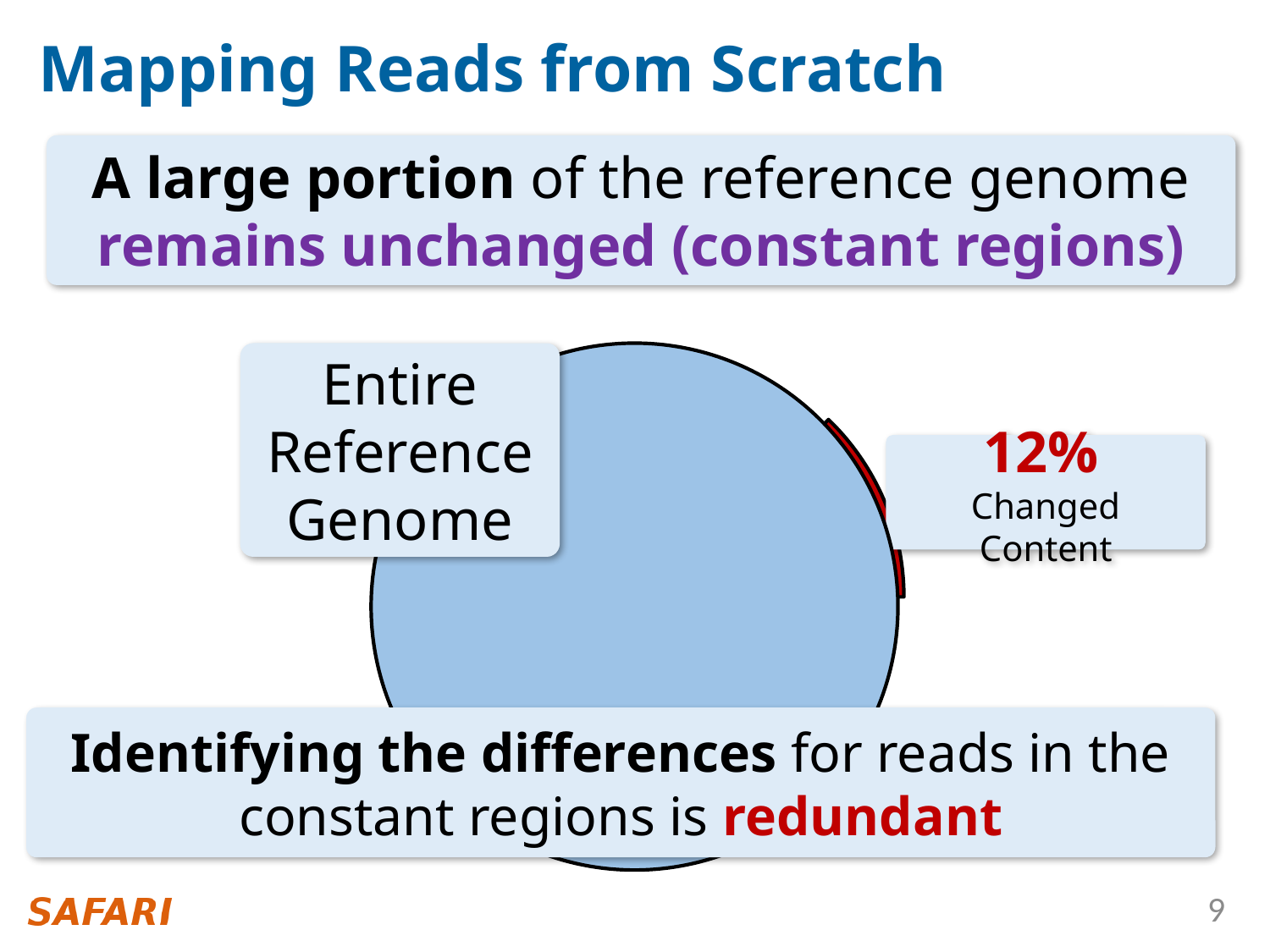
What does the whole circle of the pie chart represent? Entire Reference Genome Which is larger: the changed content slice or the remaining (unchanged) portion of the genome? the remaining (unchanged) portion How many slices does the pie chart have? 2 Which slice of the pie chart is the smallest? Changed Content What kind of chart is shown on the slide? pie chart What colour is the slice representing the changed content? red What percentage of the reference genome is labelled as changed content? 12%